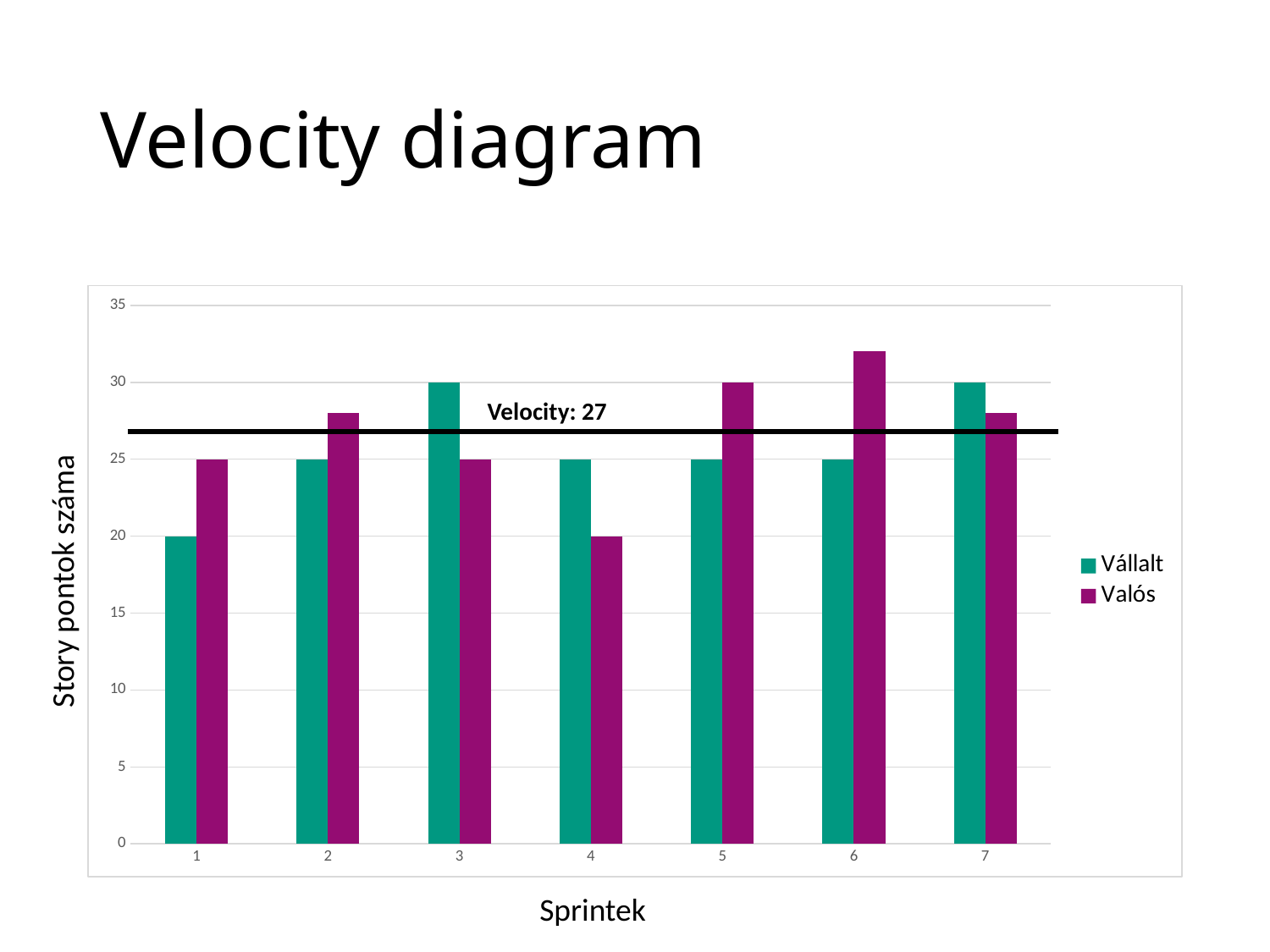
What is the Vállalt value for sprint 3? 30 What is the Valós value for sprint 4? 20 What velocity value is labelled on the horizontal line across the chart? Velocity: 27 In sprint 4, which is larger, Vállalt or Valós? Vállalt What is the Vállalt value for sprint 1? 20 How many series does the legend list? 2 Which sprint has the highest Valós value? 6 Which sprint has the lowest Vállalt value? 1 What kind of chart is shown on the slide? bar chart How many sprints are shown on the x axis? 7 What is the Valós value for sprint 5? 30 Is the Valós value for sprint 6 greater or less than 30? greater